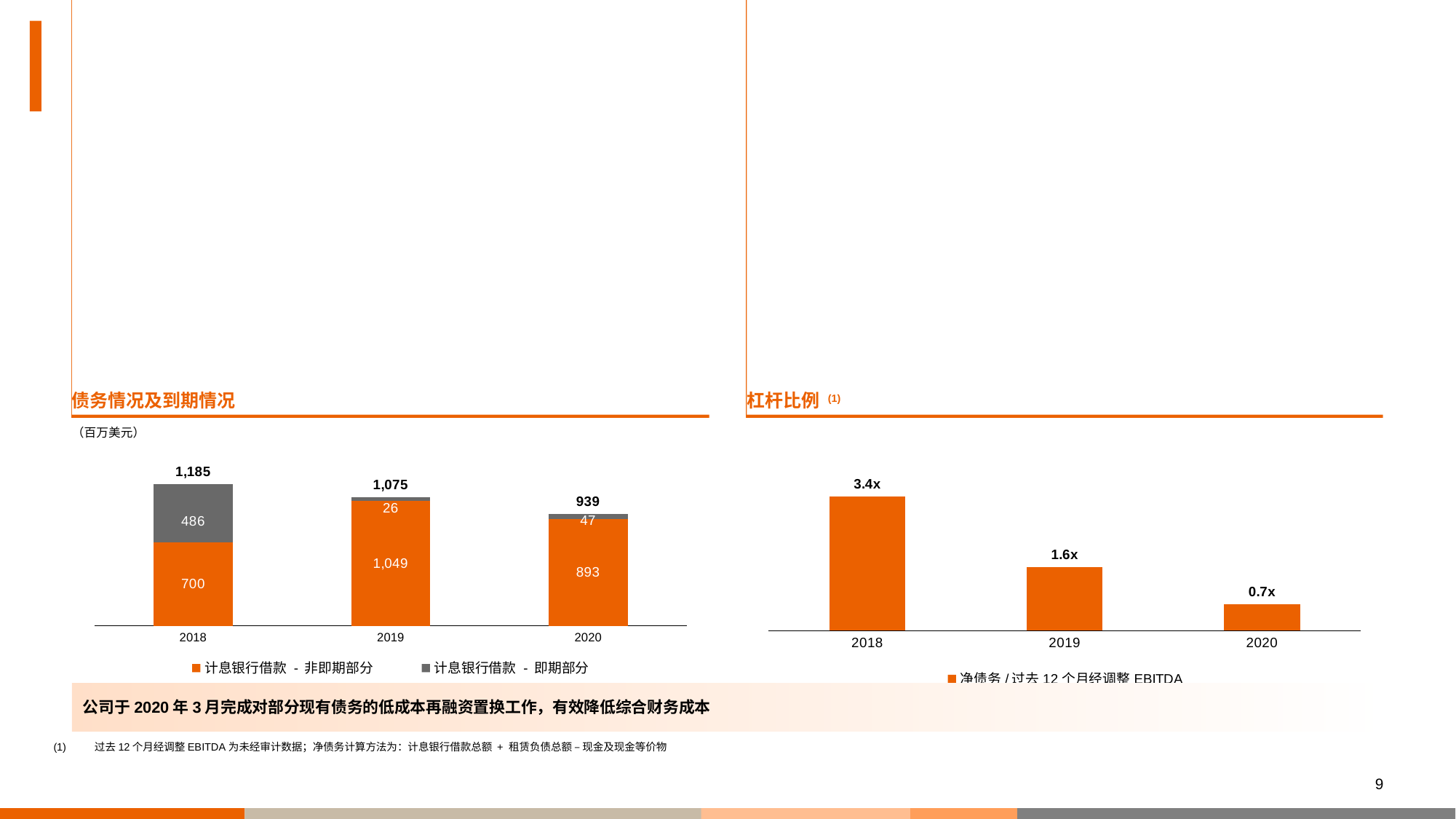
In the 债务情况及到期情况 chart, which is larger: 计息银行借款 - 非即期部分 in 2018 or in 2020? 2020 In the 杠杆比例 chart, do the values rise or fall from 2018 to 2020? fall In the 债务情况及到期情况 chart, how many series does the legend list? 2 In the 债务情况及到期情况 chart, what is the value of 计息银行借款 - 即期部分 for 2020? 47 In the 债务情况及到期情况 chart, what is the total for 2018? 1,185 In the 债务情况及到期情况 chart, which year has the lowest total? 2020 In the 债务情况及到期情况 chart, what is the difference between the 计息银行借款 - 即期部分 values for 2018 and 2019? 460 What kind of chart is the 债务情况及到期情况 chart? stacked bar chart In the 杠杆比例 chart, what is the value for 2018? 3.4x In the 杠杆比例 chart, how many years are shown? 3 In the 债务情况及到期情况 chart, what is the value of 计息银行借款 - 非即期部分 for 2019? 1,049 In the 杠杆比例 chart, which year has the highest value? 2018